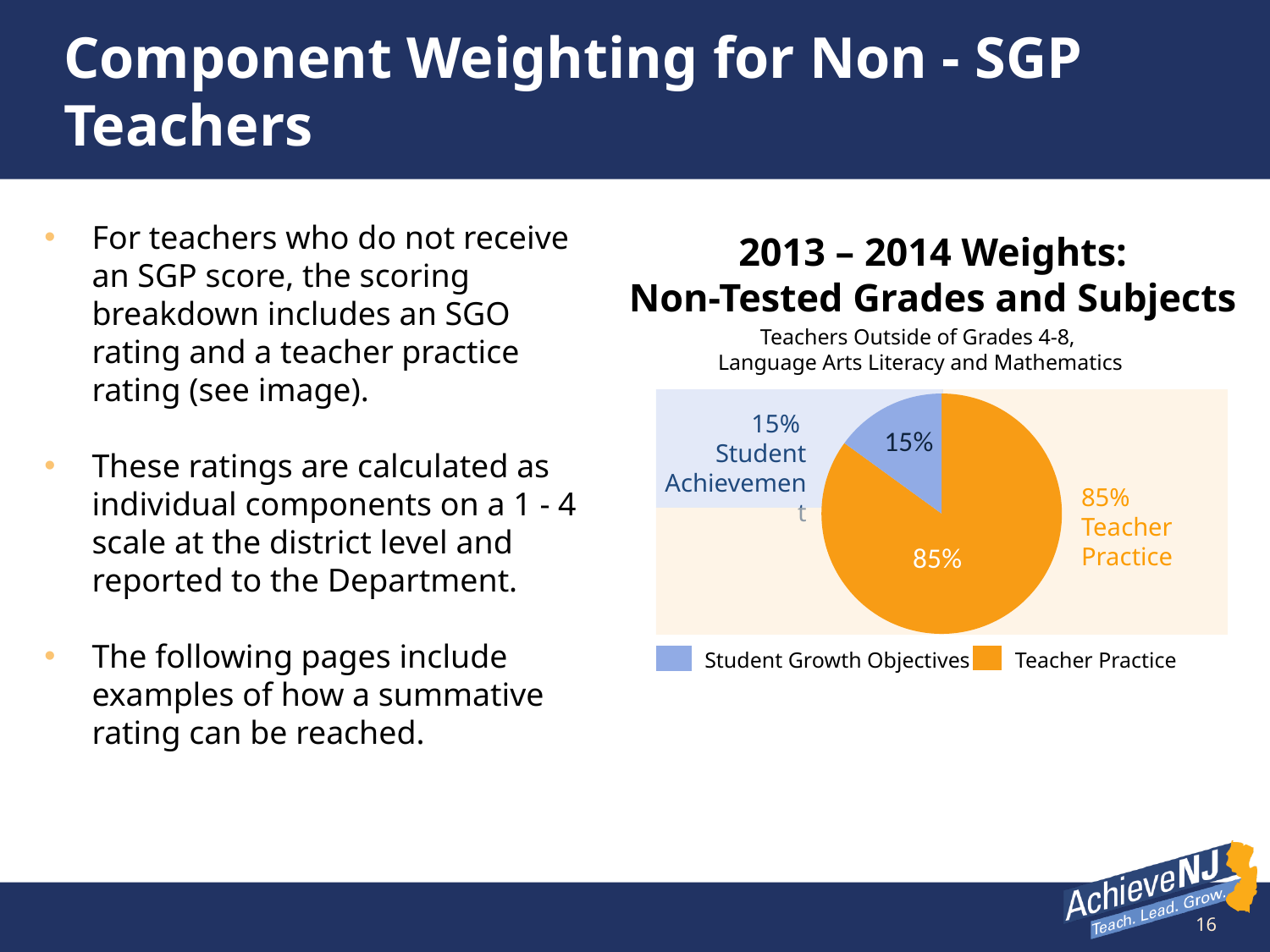
Which slice of the pie is the smallest? Student Growth Objectives Which slice of the pie is the largest? Teacher Practice What share of the pie does Student Growth Objectives represent? 15% Which is larger, the Teacher Practice slice or the Student Growth Objectives slice? Teacher Practice How many entries does the chart legend list? 2 What colour is the Teacher Practice slice of the pie? orange What share of the pie does Teacher Practice represent? 85% How many slices does the pie chart have? 2 What is the difference in percentage points between the Teacher Practice slice and the Student Growth Objectives slice? 70 What is the title of the chart? 2013 – 2014 Weights: Non-Tested Grades and Subjects What kind of chart is shown on the slide? pie chart